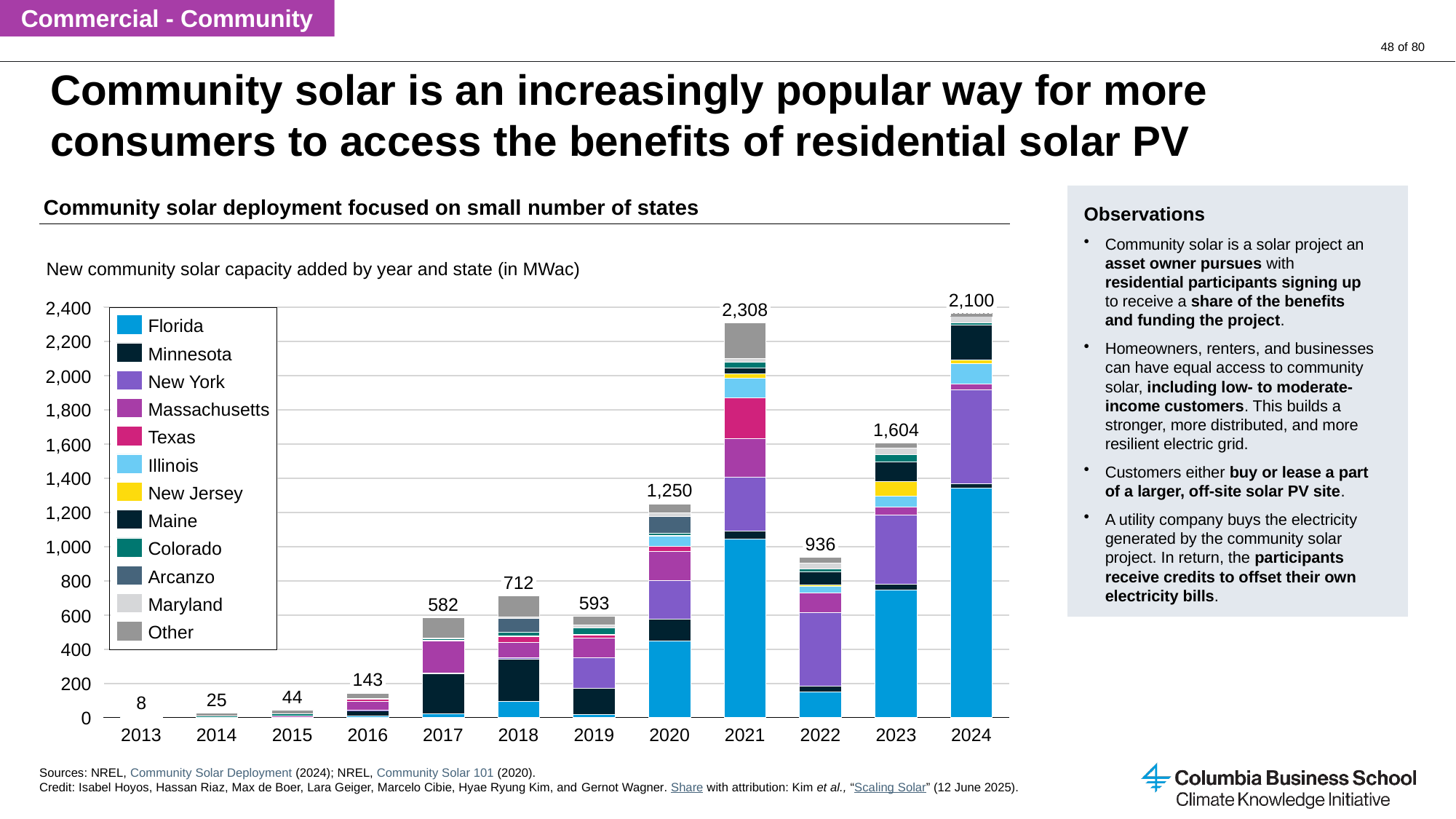
What kind of chart is shown on the slide? Stacked bar chart How many years are shown on the x axis of the chart? 12 Is the Florida segment of the 2024 bar greater or less than 1,200? greater Do the total values rise or fall from 2013 to 2021? Rise How many series does the legend list? 12 What is the difference between the total capacity added in 2021 and in 2024? 208 Which year has a larger total capacity added, 2018 or 2019? 2018 Which year has the lowest total new community solar capacity added? 2013 What is the total new community solar capacity added in 2016? 143 What is the total new community solar capacity added in 2024? 2,100 What is the total new community solar capacity added in 2021? 2,308